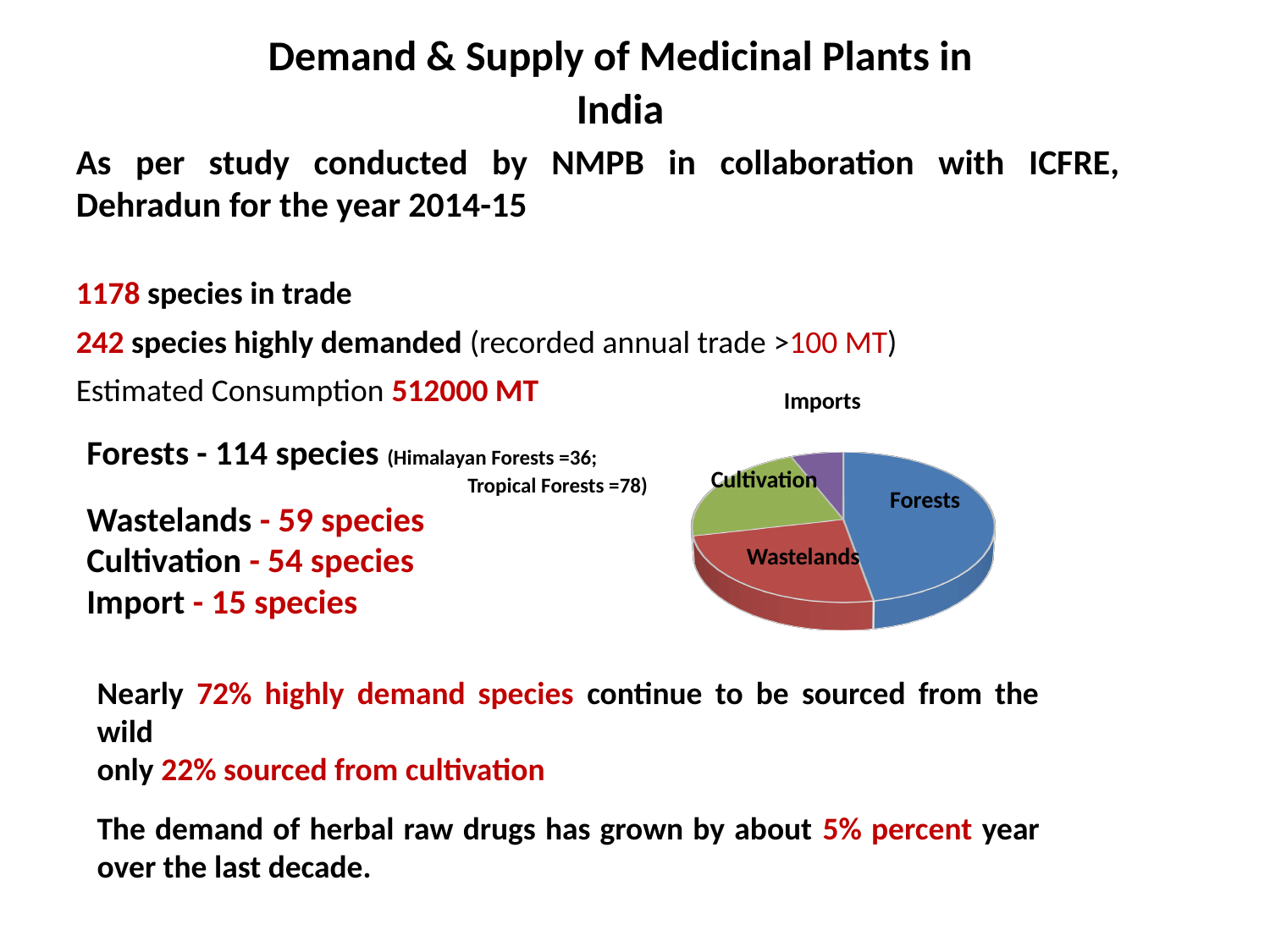
How many species does the Import slice of the pie chart represent, according to the slide? 15 species What colour is the Cultivation slice in the pie chart? green Which is larger in the pie chart, Forests or Wastelands? Forests What colour is the Forests slice in the pie chart? blue Which slice of the pie chart is the largest? Forests Which is larger in the pie chart, Cultivation or Imports? Cultivation What is the difference in species count between the Forests and Wastelands slices? 55 How many species does the Wastelands slice of the pie chart represent, according to the slide? 59 species What kind of chart is shown on the slide? pie chart How many slices does the pie chart have? 4 How many species does the Forests slice of the pie chart represent, according to the slide? 114 species Which slice of the pie chart is the smallest? Imports